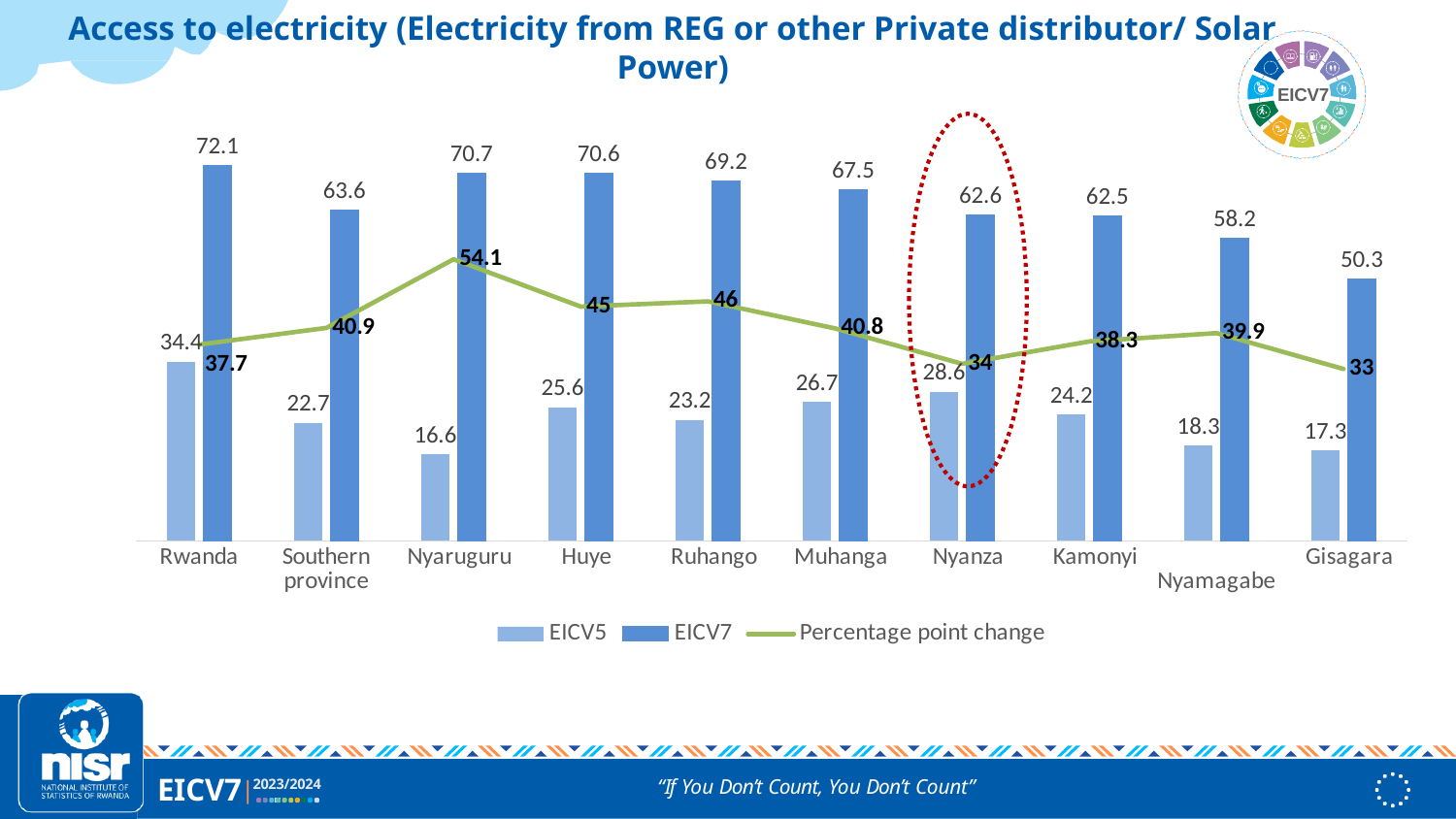
How many series does the legend list? 3 Which category has the highest EICV7 value? Rwanda What is the difference between the EICV7 and EICV5 values for Rwanda? 37.7 What is the EICV5 value for Nyaruguru? 16.6 What kind of chart is this? Bar chart with a line How many categories are shown on the x axis? 10 Which category has the highest percentage point change? Nyaruguru Which category is highlighted with a red dotted circle? Nyanza Which category has the lowest EICV5 value? Nyaruguru Which has the larger EICV5 value, Kamonyi or Nyamagabe? Kamonyi What is the EICV7 value for Nyanza? 62.6 What is the percentage point change for Gisagara? 33